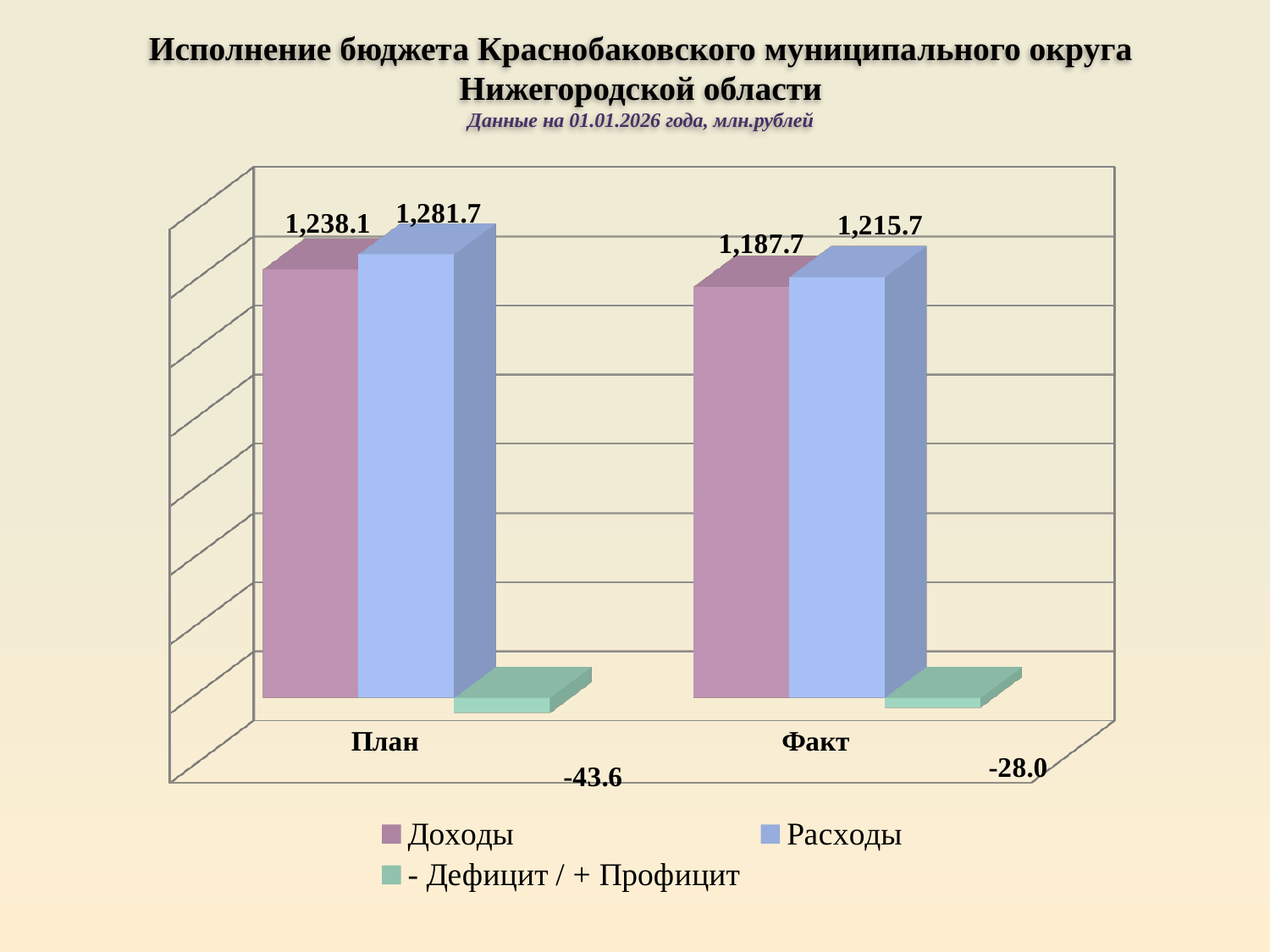
How many series does the legend list? 3 Which series is shown in green in the legend? - Дефицит / + Профицит What is the value of - Дефицит / + Профицит for План? -43.6 What is the difference between Доходы for План and Доходы for Факт? 50.4 Which series has the highest value in the Факт category? Расходы What is the value of - Дефицит / + Профицит for Факт? -28.0 What is the value of Доходы for План? 1,238.1 How many categories are shown on the x axis? 2 What is the difference between Расходы and Доходы for План? 43.6 What kind of chart is shown on the slide? Bar chart What is the value of Расходы for Факт? 1,215.7 Which category has the higher value for Расходы, План or Факт? План